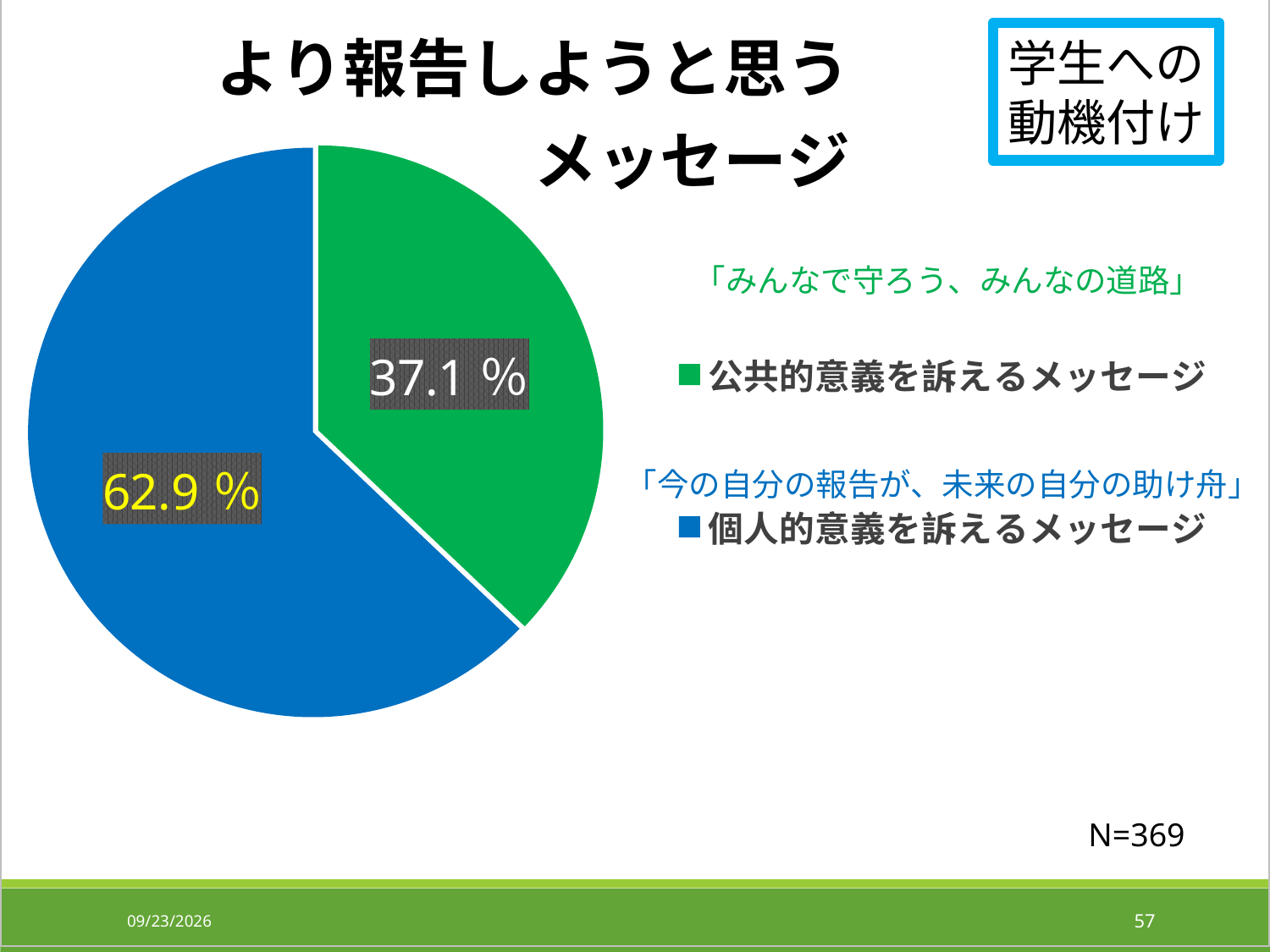
How many slices does the pie chart have? 2 What is the sample size (N) shown on the slide? N=369 What share of the pie is labelled for 個人的意義を訴えるメッセージ? 62.9 % Which category has the largest slice of the pie? 個人的意義を訴えるメッセージ What kind of chart is shown on the slide? pie chart Which category has the smallest slice of the pie? 公共的意義を訴えるメッセージ Which is larger: the slice for 公共的意義を訴えるメッセージ or the slice for 個人的意義を訴えるメッセージ? 個人的意義を訴えるメッセージ What is the difference in percentage points between the 個人的意義を訴えるメッセージ slice and the 公共的意義を訴えるメッセージ slice? 25.8 Is the share for 個人的意義を訴えるメッセージ greater or less than 50%? greater How many entries does the legend list? 2 What colour is the slice for 公共的意義を訴えるメッセージ? green What share of the pie is labelled for 公共的意義を訴えるメッセージ? 37.1 %